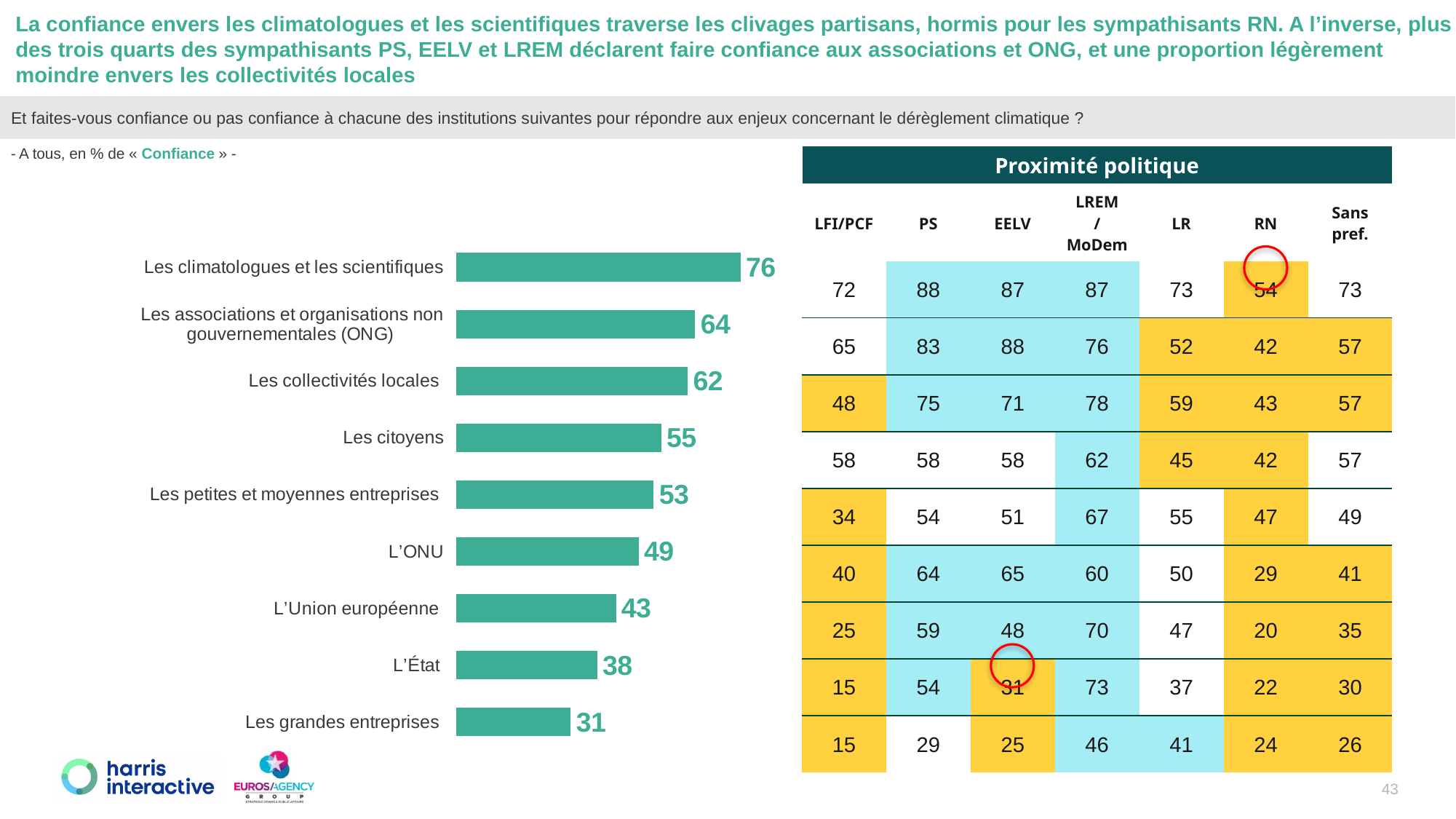
What kind of chart is shown on the left of the slide? Bar chart What value is shown for « Les climatologues et les scientifiques » in the bar chart? 76 Which category has the highest value in the bar chart? Les climatologues et les scientifiques What colour are the bars in the bar chart? Green In the bar chart, which is larger: the value for « L'Union européenne » or the value for « L'ONU »? L'ONU What value is shown for « L'État » in the bar chart? 38 Which category has the lowest value in the bar chart? Les grandes entreprises What is the difference between the values for « Les collectivités locales » and « Les citoyens » in the bar chart? 7 What value is shown for « L'ONU » in the bar chart? 49 What is the difference between the values for « Les climatologues et les scientifiques » and « Les grandes entreprises » in the bar chart? 45 In the bar chart, which is larger: the value for « Les petites et moyennes entreprises » or the value for « L'État »? Les petites et moyennes entreprises How many categories are shown in the bar chart? 9